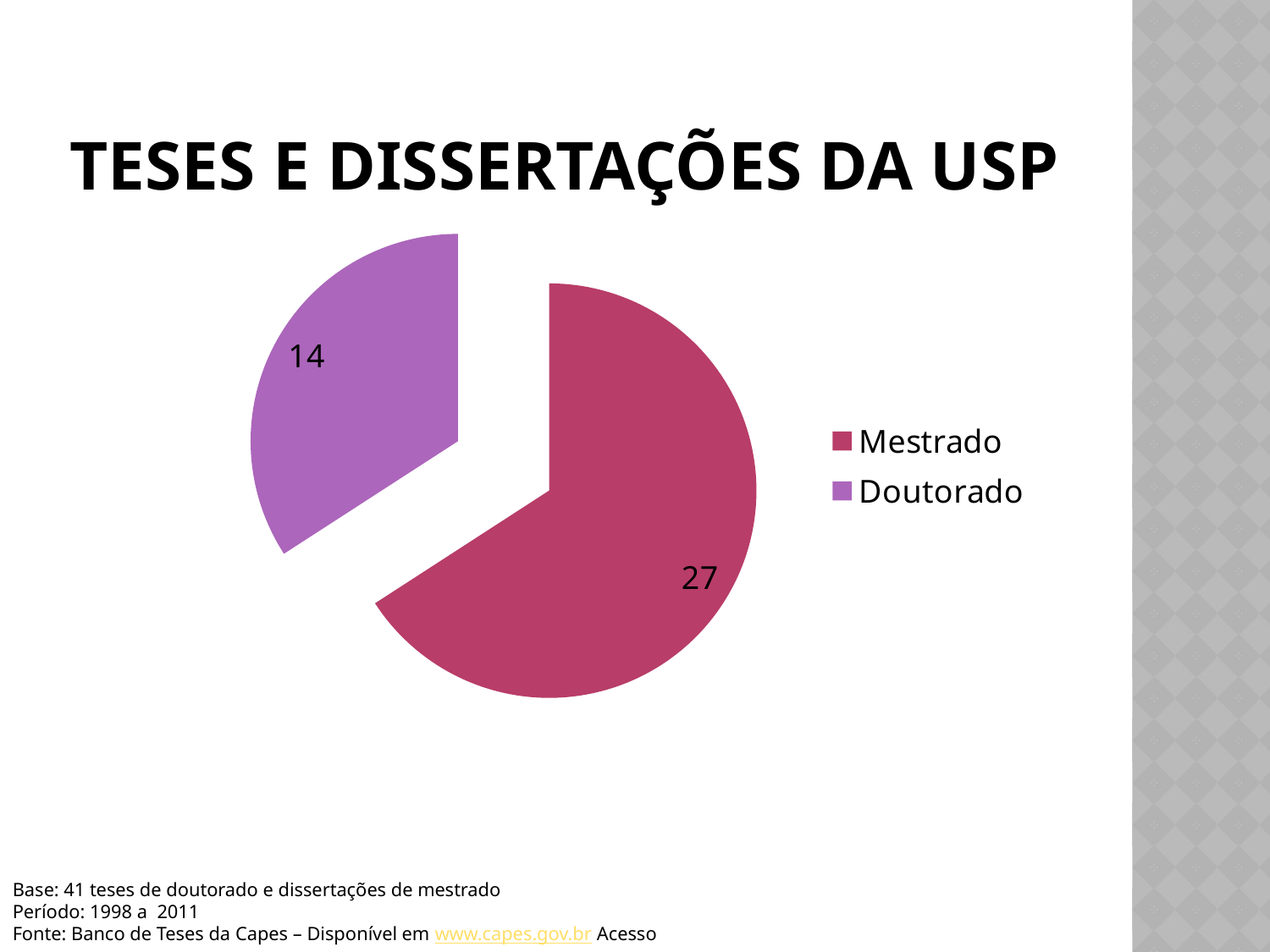
What is the total of the two slices? 41 Which category has the largest slice? Mestrado What is the title of the slide containing the chart? TESES E DISSERTAÇÕES DA USP Which is larger, Mestrado or Doutorado? Mestrado What is the difference between the Mestrado and Doutorado values? 13 How many entries does the legend list? 2 What is the value for Doutorado? 14 How many categories does the pie chart show? 2 What colour is the Doutorado slice? purple What kind of chart is shown on the slide? pie chart Which category has the smallest slice? Doutorado What is the value for Mestrado? 27